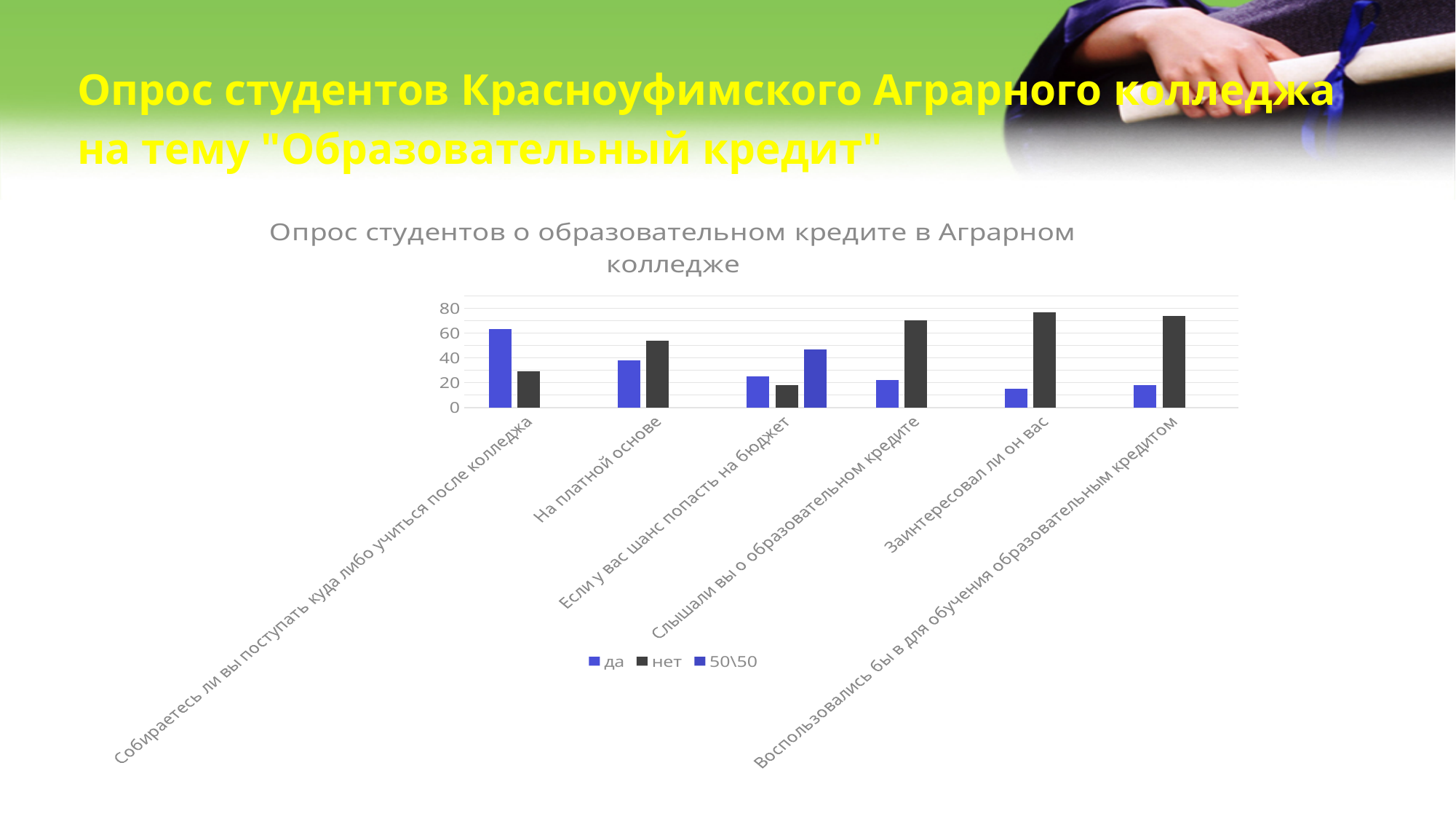
Is the value of 'да' for 'Заинтересовал ли он вас' greater or less than 20? less What is the title of the chart? Опрос студентов о образовательном кредите в Аграрном колледже Is the value of 'нет' for 'Заинтересовал ли он вас' greater or less than 60? greater For 'На платной основе', which is larger: 'да' or 'нет'? нет How many categories (questions) are shown on the x axis of the chart? 6 Which category has the highest 'да' value? Собираетесь ли вы поступать куда либо учиться после колледжа Which category has the lowest 'нет' value? Если у вас шанс попасть на бюджет What kind of chart is shown on the slide? bar chart Is the value of 'да' for 'Собираетесь ли вы поступать куда либо учиться после колледжа' greater or less than 60? greater How many series does the chart legend list? 3 Which series are listed in the chart legend? да, нет, 50\50 For 'Собираетесь ли вы поступать куда либо учиться после колледжа', which is larger: 'да' or 'нет'? да